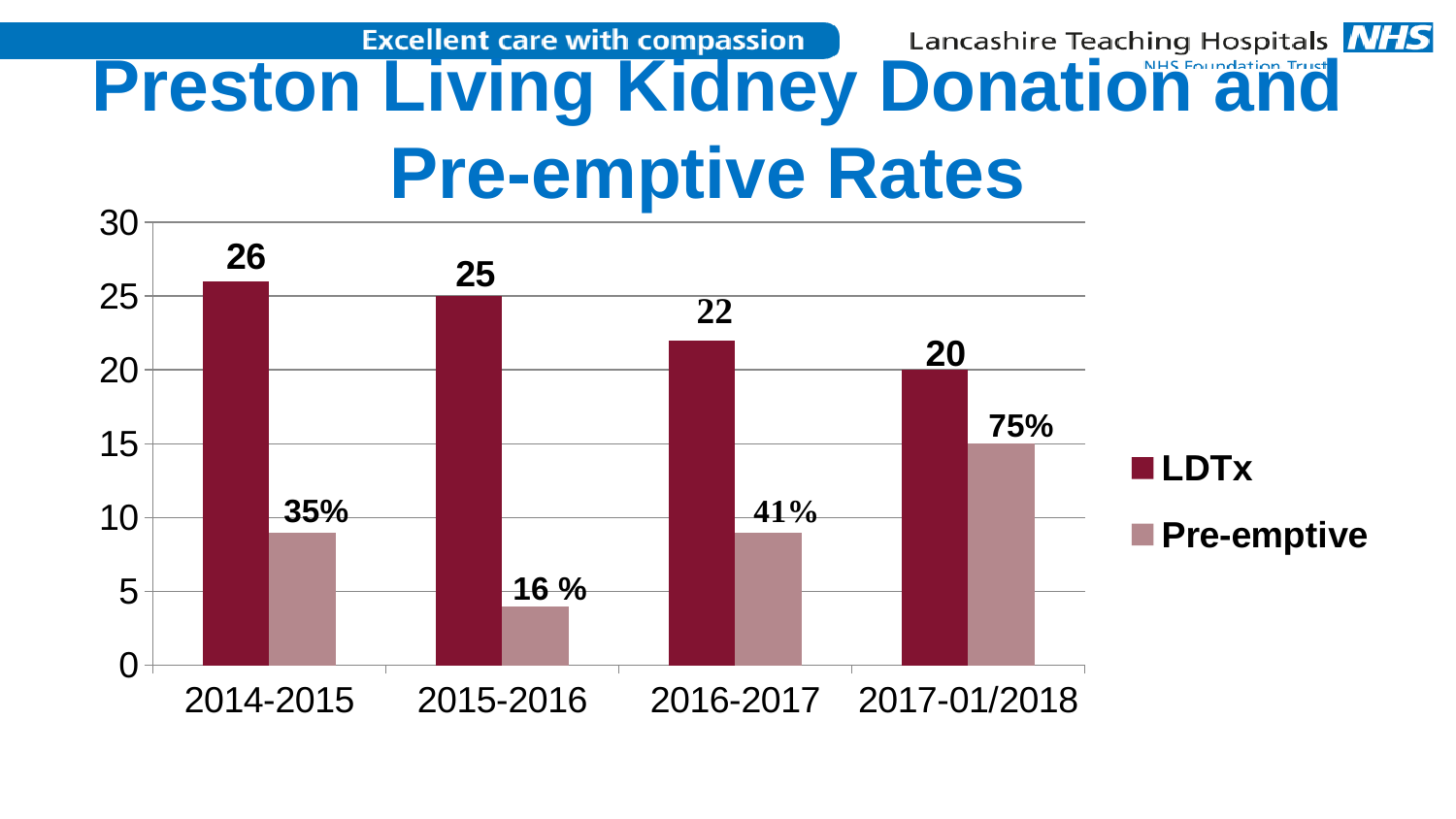
What is the difference between the LDTx values for 2014-2015 and 2017-01/2018? 6 What type of chart is shown on the slide? bar chart What is the LDTx value for 2016-2017? 22 Do the LDTx values rise or fall across the periods from 2014-2015 to 2017-01/2018? fall What data label is shown on the Pre-emptive bar for 2017-01/2018? 75% What is the LDTx value for 2014-2015? 26 Which period has the lowest LDTx value? 2017-01/2018 Which period has the highest LDTx value? 2014-2015 Which is larger, the LDTx value for 2015-2016 or for 2016-2017? 2015-2016 How many series does the legend list? 2 What is the LDTx value for 2017-01/2018? 20 Is the Pre-emptive bar for 2015-2016 greater or less than 5 on the axis? less